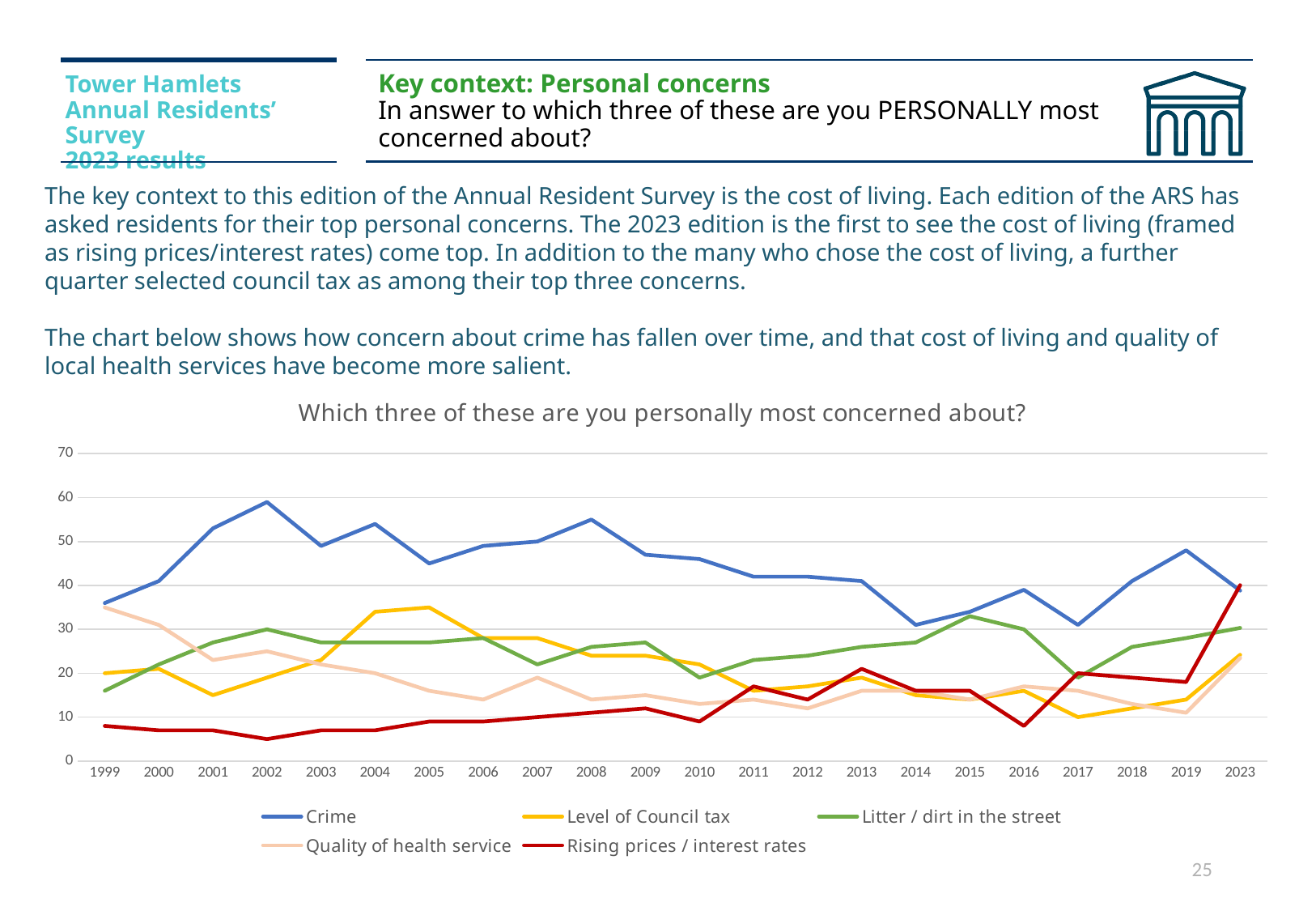
Is the value for Rising prices / interest rates in 2023 greater or less than 30? greater How many series does the chart legend list? 5 What kind of chart is shown on the slide? line chart In which year does the Rising prices / interest rates series reach its highest value? 2023 Is the value for Crime in 2014 greater or less than 40? less Is the value for Crime in 2002 greater or less than 50? greater In which year does the Crime series reach its highest value? 2002 In 1999, which is larger: Crime or Litter / dirt in the street? Crime What is the title of the chart? Which three of these are you personally most concerned about? Does the Crime series rise or fall between 2002 and 2014? fall How many years are shown along the x axis of the chart? 22